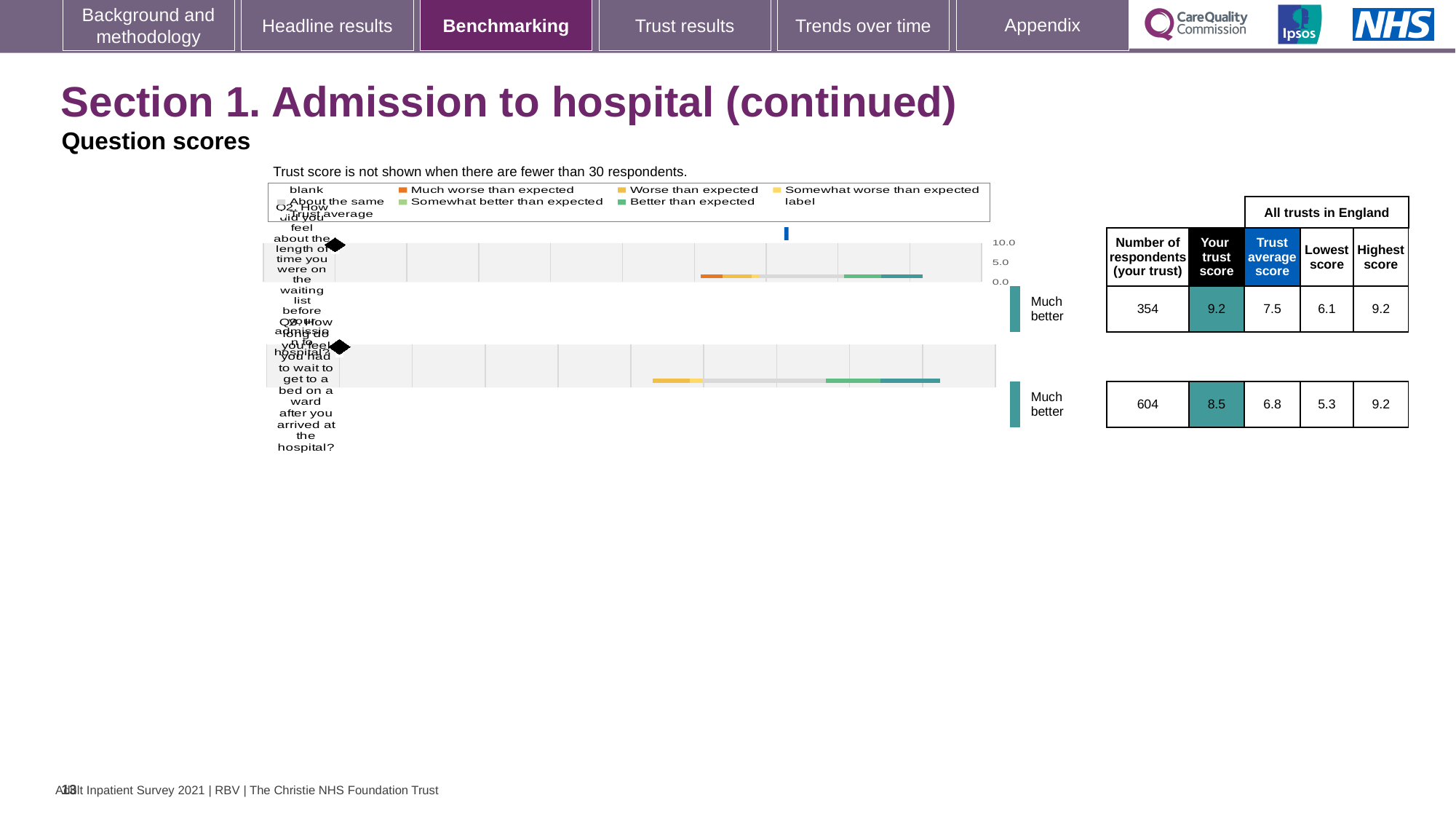
What kind of chart is used to show the question scores? Bar chart How many questions are plotted in the benchmarking chart? 2 What is the trust average score for Q3 (how long did you feel you had to wait to get to a bed on a ward)? 6.8 What is the highest score across all trusts in England for Q2 (length of time on the waiting list)? 9.2 What is the lowest score across all trusts in England for Q3 (wait to get to a bed on a ward)? 5.3 What rating label is shown to the right of each question's bar in the chart? Much better Is your trust score for Q3 (wait to get to a bed on a ward) greater or less than 5.0? greater How much higher is your trust score than the trust average score for Q2 (length of time on the waiting list)? 1.7 What is your trust score for Q2 (length of time on the waiting list before admission)? 9.2 Which question has the higher trust score for your trust, Q2 (waiting list) or Q3 (wait for a bed on a ward)? Q2 How many more respondents answered Q3 than Q2 at your trust? 250 How many respondents from your trust answered Q2 (how did you feel about the length of time you were on the waiting list)? 354